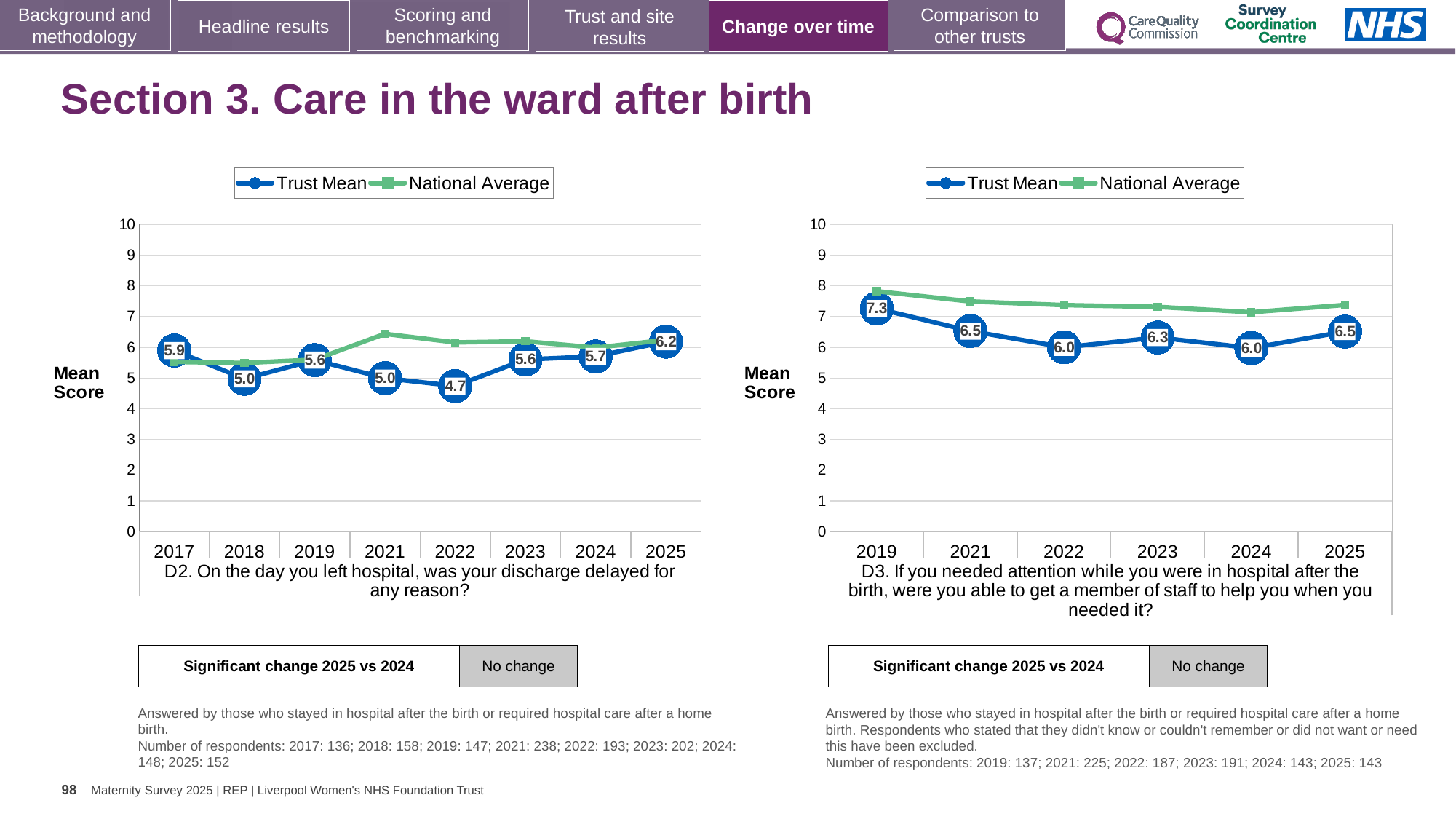
In the right chart (D3, able to get a member of staff to help), what is the Trust Mean score for 2023? 6.3 In the left chart (D2, discharge delayed), what is the Trust Mean score for 2025? 6.2 In the left chart (D2, discharge delayed), what is the Trust Mean score for 2022? 4.7 What type of chart is the left chart (D2, discharge delayed)? line chart How many series does the legend of the right chart (D3, able to get a member of staff to help) list? 2 In the left chart (D2, discharge delayed), what is the difference between the Trust Mean scores for 2025 and 2022? 1.5 In the right chart (D3, able to get a member of staff to help), what is the Trust Mean score for 2019? 7.3 In the right chart (D3, able to get a member of staff to help), is the National Average value for 2019 greater or less than 7? greater In the left chart (D2, discharge delayed), which year has the lowest Trust Mean score? 2022 How many years are plotted on the x axis of the left chart (D2, discharge delayed)? 8 In the right chart (D3, able to get a member of staff to help), is the Trust Mean score for 2021 larger or smaller than the score for 2022? larger In the right chart (D3, able to get a member of staff to help), which year has the highest Trust Mean score? 2019